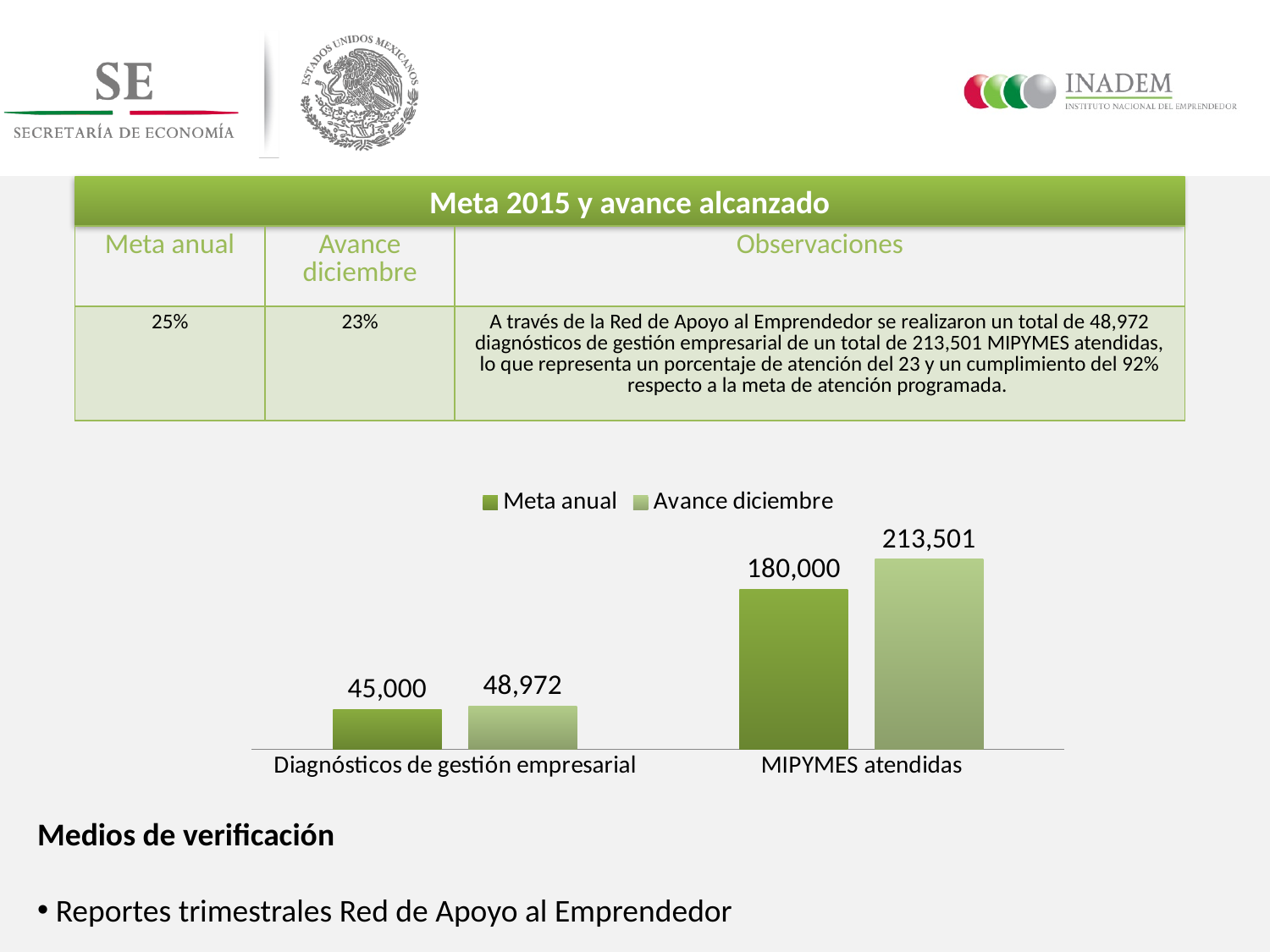
What is the Meta anual value for MIPYMES atendidas? 180,000 What kind of chart is shown on the slide? Bar chart Which category has the highest Avance diciembre value? MIPYMES atendidas What is the Avance diciembre value for MIPYMES atendidas? 213,501 What is the difference between the Avance diciembre and Meta anual values for Diagnósticos de gestión empresarial? 3,972 Which category has the lowest Meta anual value? Diagnósticos de gestión empresarial For MIPYMES atendidas, which is larger: Meta anual or Avance diciembre? Avance diciembre How many series does the chart legend list? 2 How many categories are shown on the x axis of the chart? 2 What is the Meta anual value for Diagnósticos de gestión empresarial? 45,000 What is the Avance diciembre value for Diagnósticos de gestión empresarial? 48,972 What is the difference between the Avance diciembre and Meta anual values for MIPYMES atendidas? 33,501